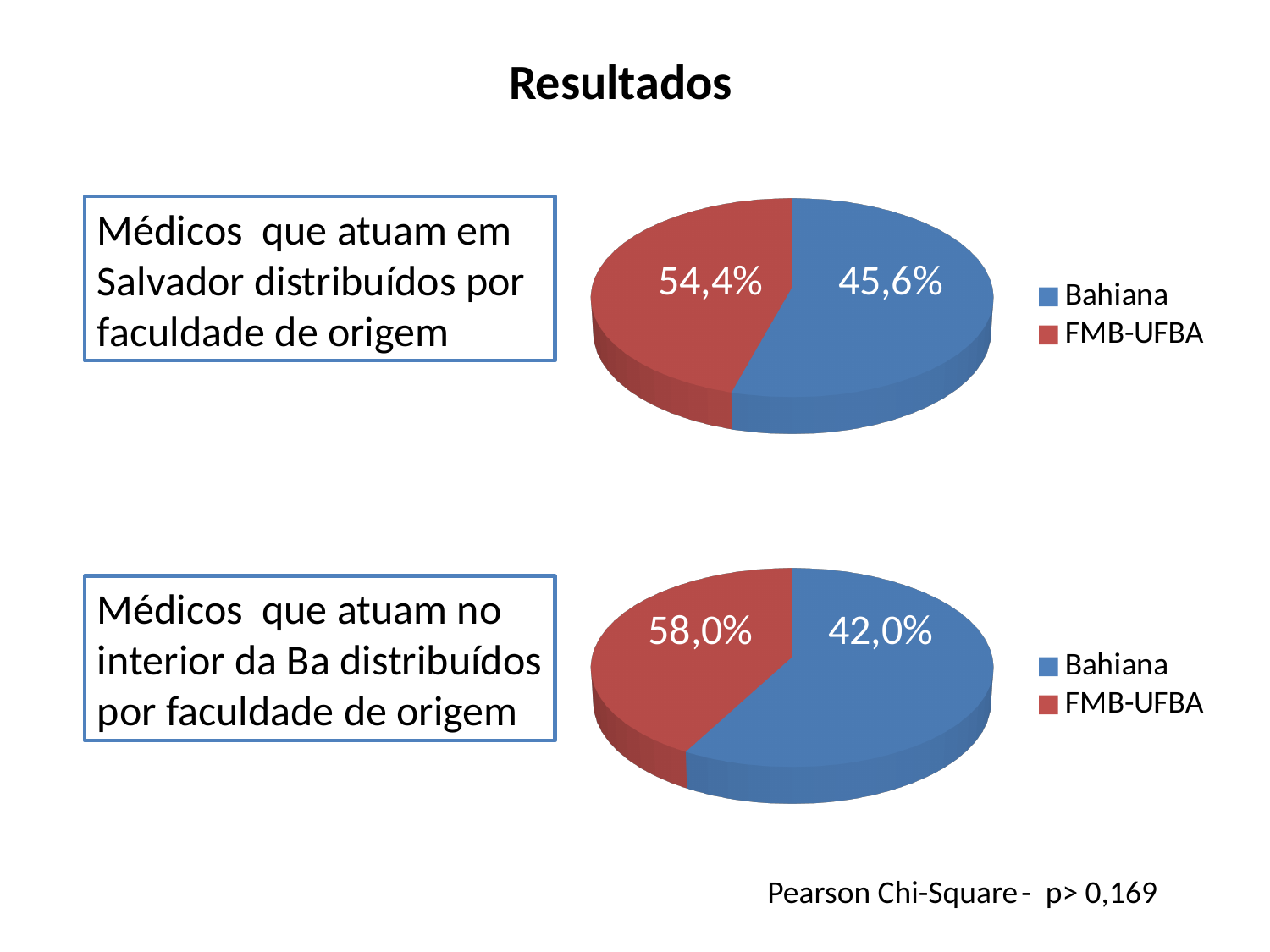
In the bottom pie chart, which category has the smaller slice? FMB-UFBA In the bottom pie chart, what is the difference in percentage points between FMB-UFBA and Bahiana? 16,0 In the top pie chart, which category has the larger slice? Bahiana Which colour represents FMB-UFBA in the pie charts? red How many categories does the legend of the top pie chart list? 2 What type of chart is used on this slide? pie chart In the top pie chart, what is the difference in percentage points between FMB-UFBA and Bahiana? 8,8